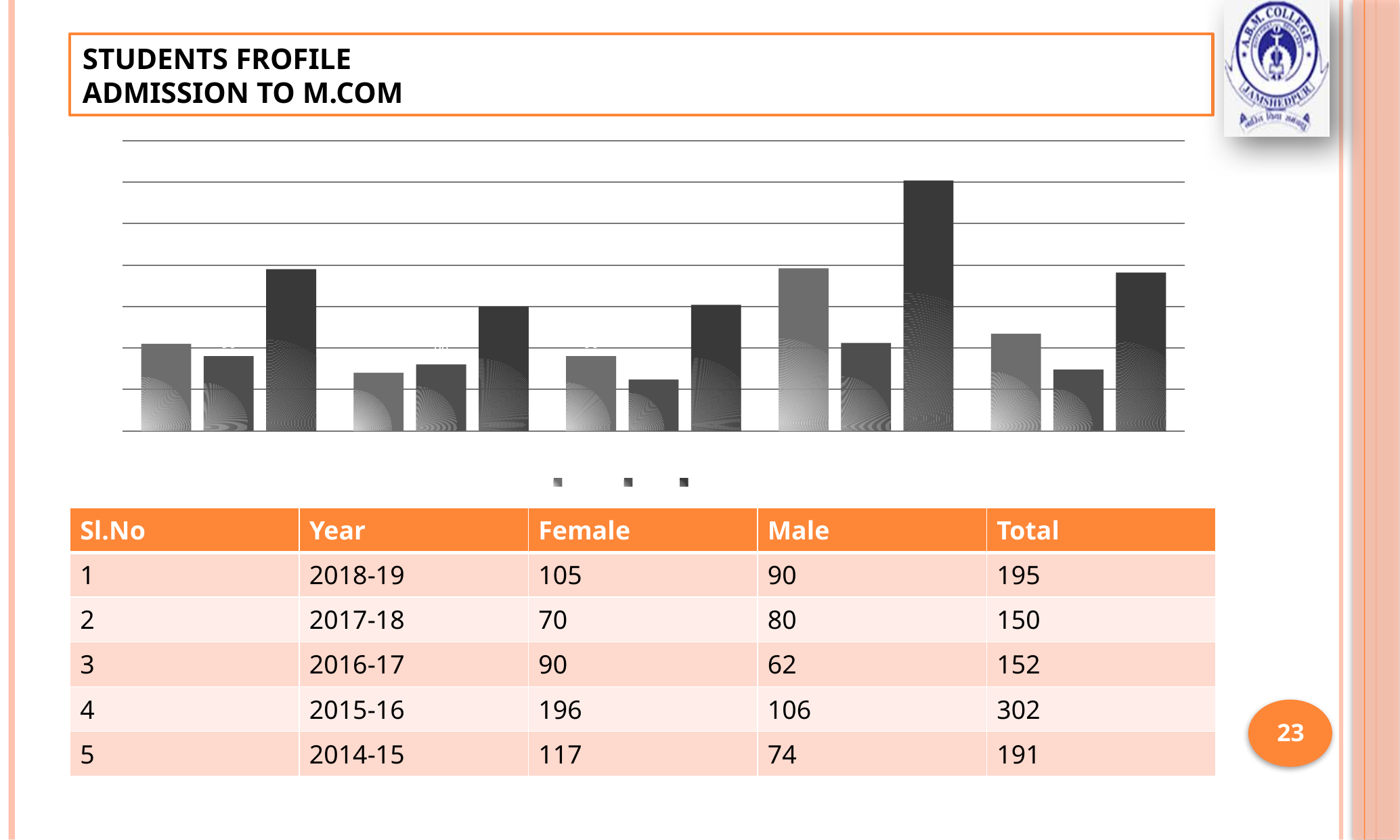
How many groups of bars does the chart show? 5 What kind of chart is shown on the slide? bar chart How many bars are in each group on the chart? 3 Which group of bars, counting from the left, contains the tallest bar on the chart? the fourth group How many series does the chart's legend list? 3 Within each group of bars, which bar is the tallest: the first, second or third? the third